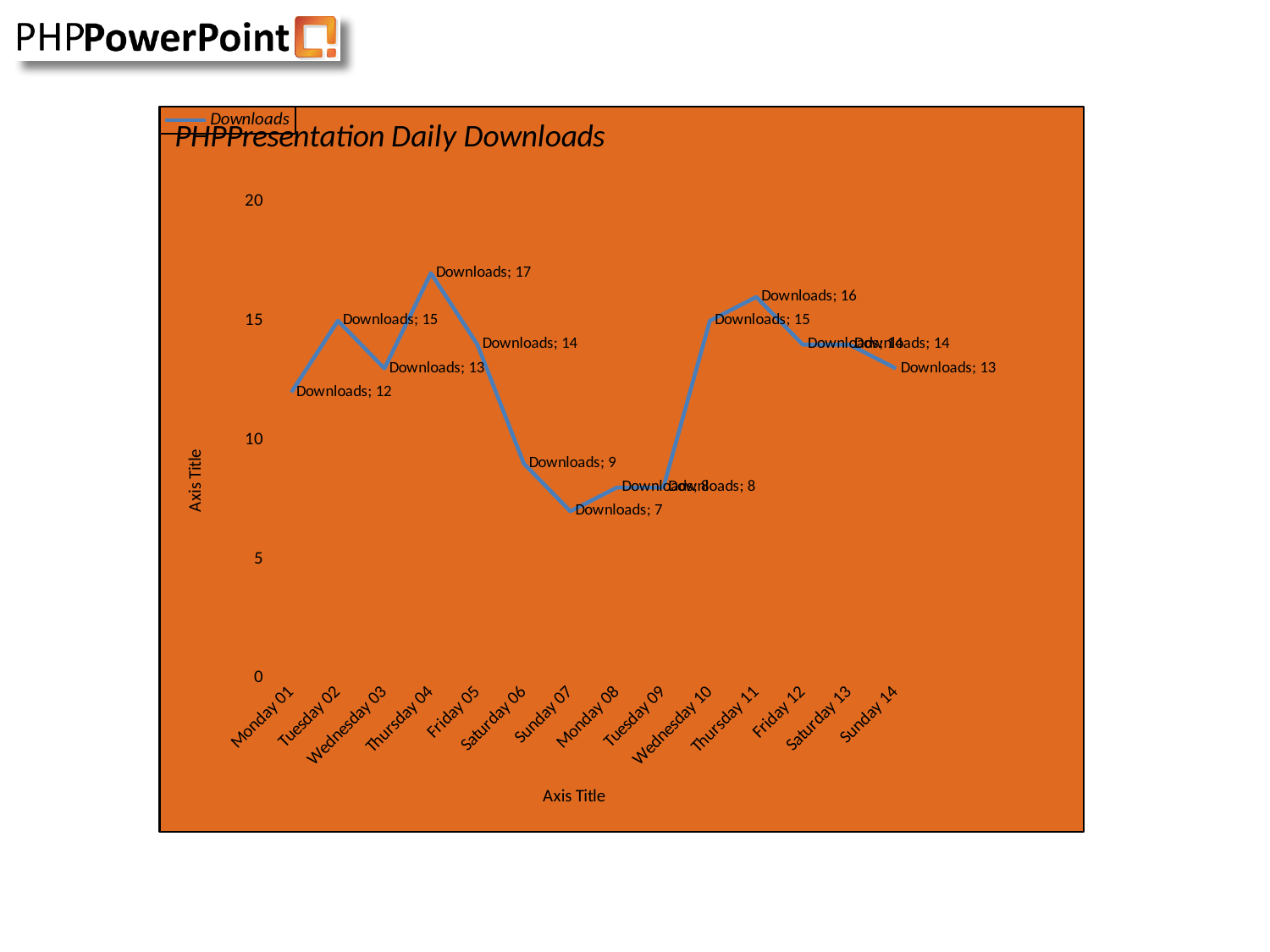
What is the Downloads value for Sunday 07? 7 Which has a larger Downloads value, Tuesday 02 or Wednesday 03? Tuesday 02 What is the title of the chart? PHPPresentation Daily Downloads What is the Downloads value for Monday 01? 12 What is the difference between the Downloads values for Thursday 04 and Sunday 07? 10 What type of chart is shown on the slide? line chart What is the Downloads value for Thursday 04? 17 How many series does the legend list? 1 Which day has the highest Downloads value? Thursday 04 How many categories are plotted along the x axis? 14 Which day has the lowest Downloads value? Sunday 07 Do the Downloads values rise or fall from Thursday 04 to Sunday 07? fall